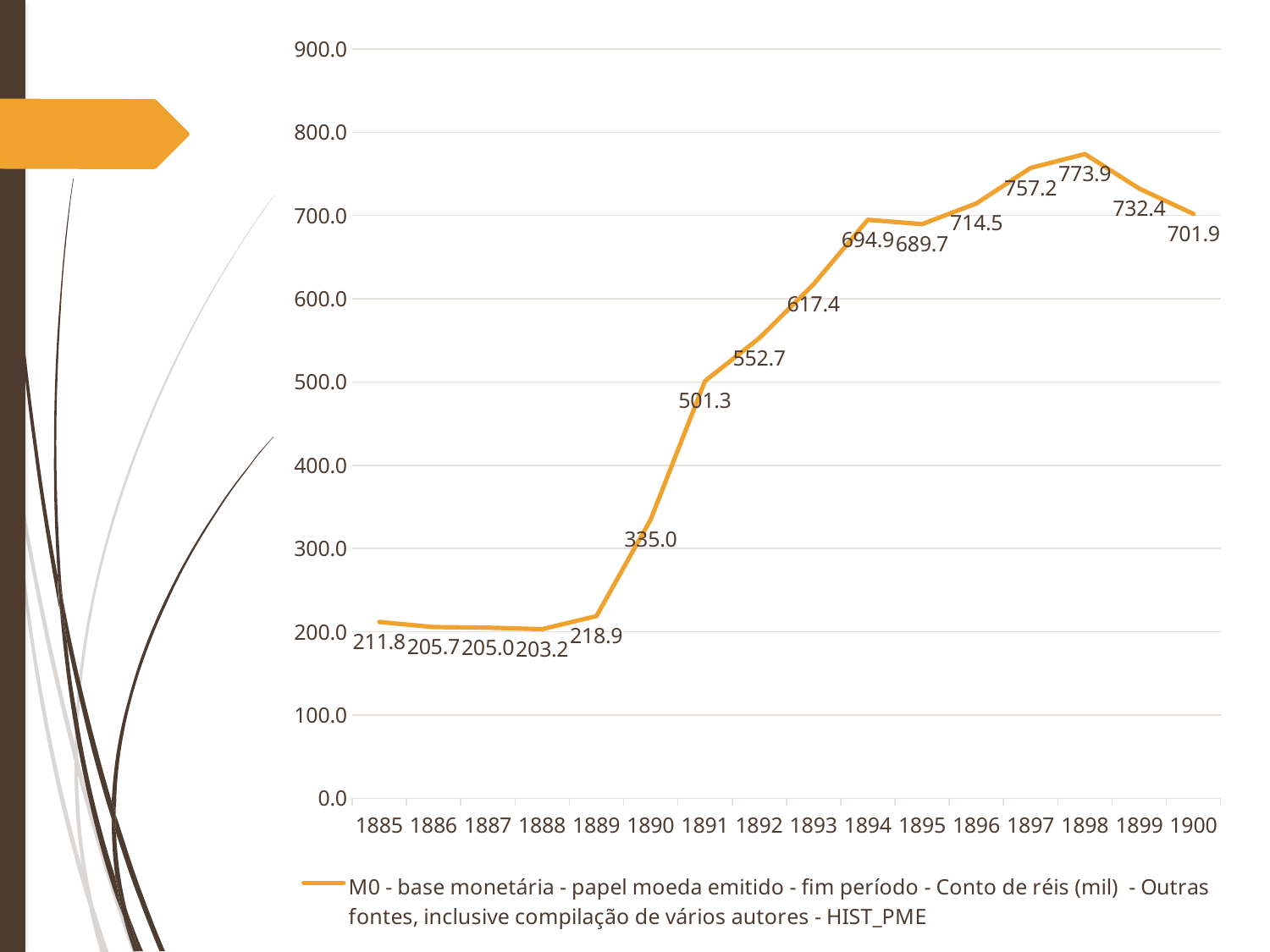
Which is larger, the value for 1894 or the value for 1895? 1894 Which year has the highest value? 1898 Do the values rise or fall from 1889 to 1894? rise What is the value for 1890? 335.0 What is the difference between the values for 1891 and 1890? 166.3 Is the value for 1892 greater or less than 500.0? greater Which year has the lowest value? 1888 How many years are shown on the x axis? 16 What is the value for 1885? 211.8 How many series does the legend list? 1 What kind of chart is shown? line chart What is the value for 1898? 773.9